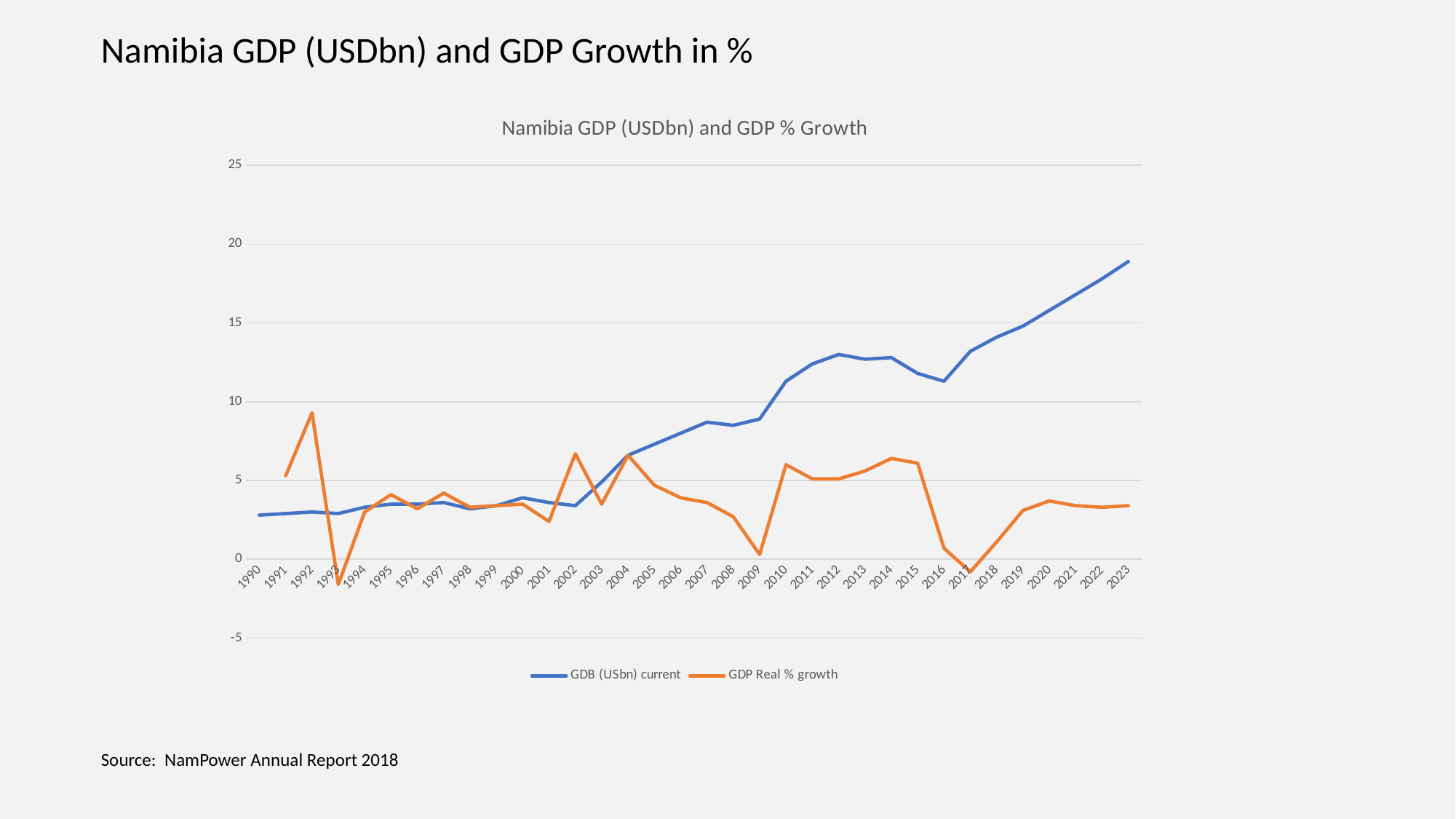
Which is larger, GDP Real % growth in 1992 or in 2009? 1992 In which year is the GDP Real % growth line at its highest? 1992 Does the GDB (USbn) current line generally rise or fall from 1990 to 2023? Rise In which year is the GDP Real % growth line at its lowest? 1993 Is the value for GDB (USbn) current in 2023 greater or less than 15? greater In which year is the GDB (USbn) current line at its highest? 2023 What is the title of the chart? Namibia GDP (USDbn) and GDP % Growth Is the value for GDP Real % growth in 2017 greater or less than 0? less How many series does the legend list? 2 Which series is drawn in orange? GDP Real % growth How many years are shown along the x axis? 34 What kind of chart is shown on the slide? Line chart